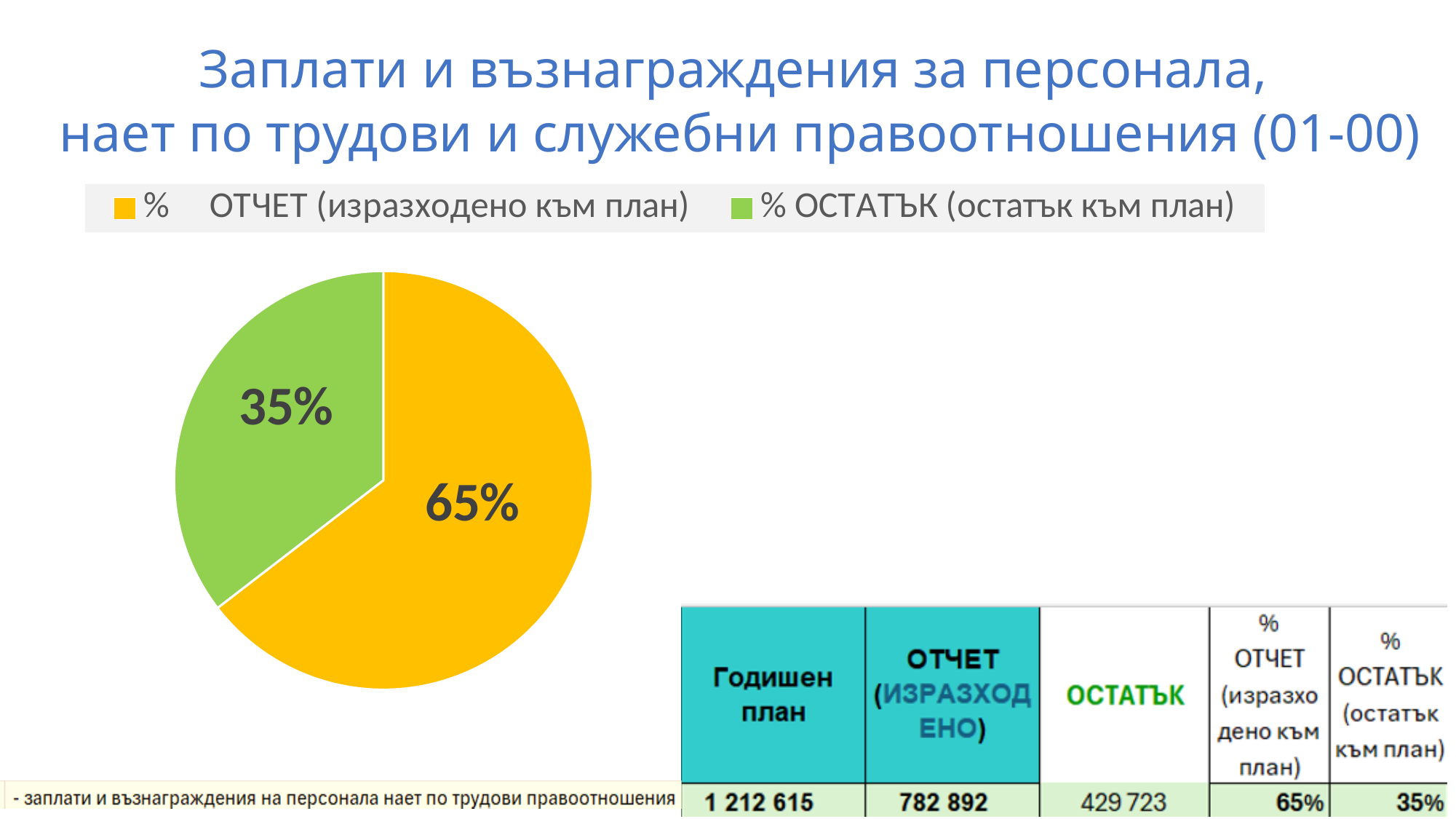
What kind of chart is shown on the slide? pie chart How many entries does the legend of the pie chart list? 2 What value is labelled on the orange slice of the pie chart? 65% How many slices does the pie chart have? 2 Which slice of the pie chart is the largest? % ОТЧЕТ (изразходено към план) What is the difference in percentage points between the "% ОТЧЕТ" slice and the "% ОСТАТЪК" slice? 30% What share of the pie does the "% ОСТАТЪК (остатък към план)" slice represent? 35% What colour is the "% ОСТАТЪК (остатък към план)" slice in the pie chart? green Which slice of the pie chart is the smallest? % ОСТАТЪК (остатък към план) What share of the pie does the "% ОТЧЕТ (изразходено към план)" slice represent? 65% Which is larger in the pie chart: the "% ОТЧЕТ" slice or the "% ОСТАТЪК" slice? % ОТЧЕТ (изразходено към план) What value is labelled on the green slice of the pie chart? 35%